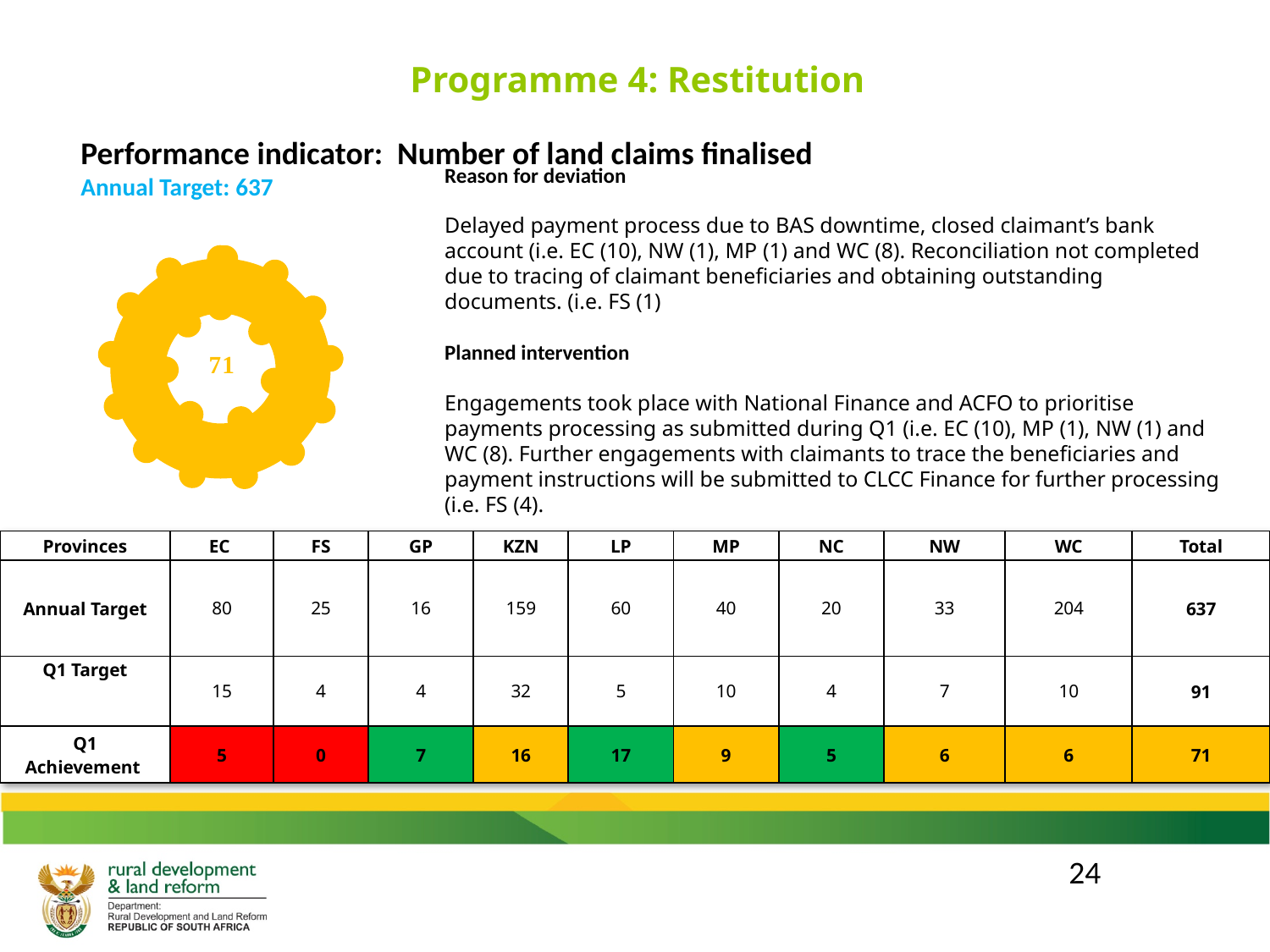
What colour is the ring of the doughnut chart? yellow Does the doughnut chart display a legend? No What kind of chart is shown on the left of the slide? doughnut chart What value is printed in the centre of the doughnut chart? 71